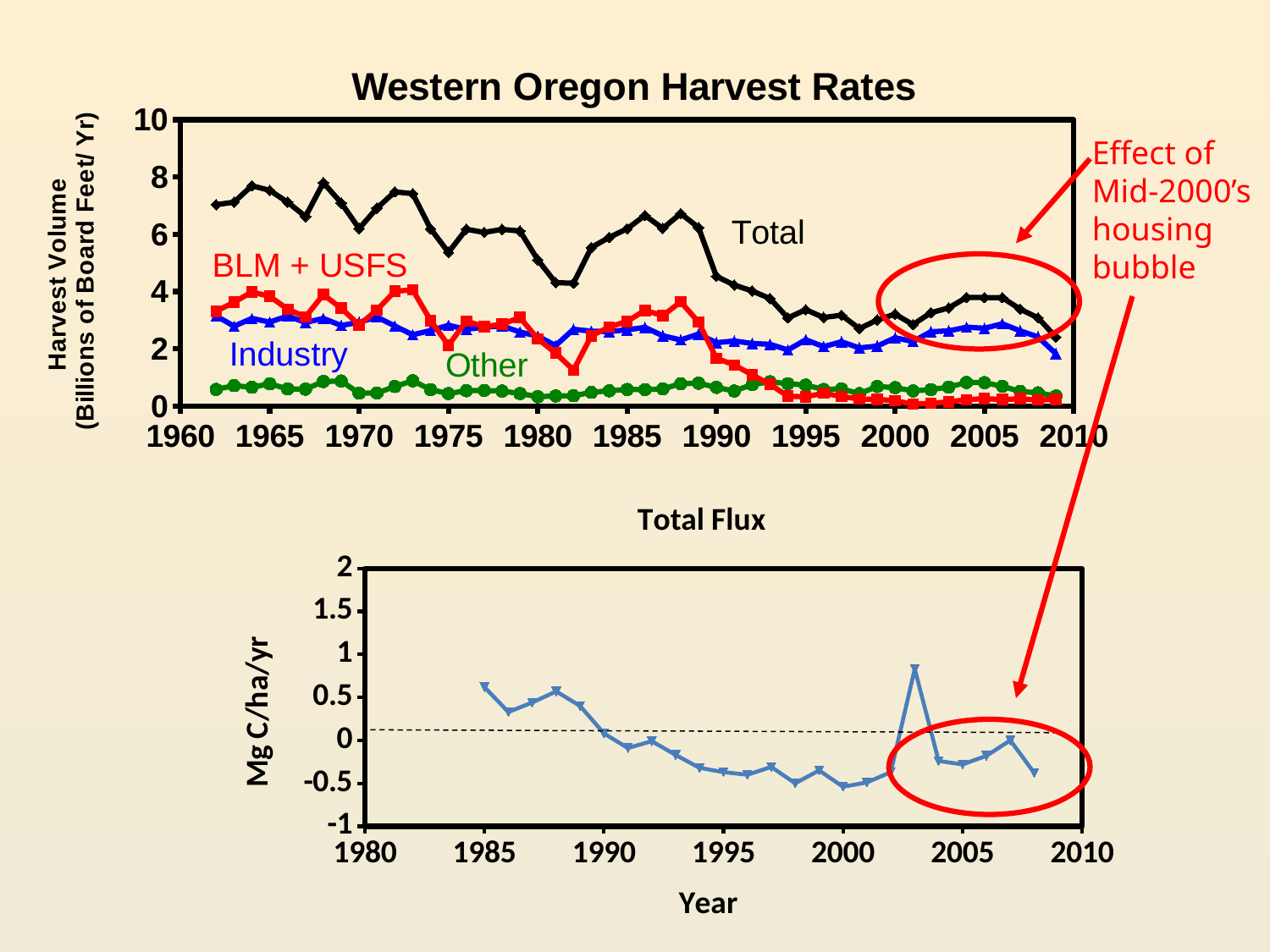
On the Total Flux chart, in which year is the value highest? 2003 What kind of chart is the Total Flux chart? line chart What is the y-axis label of the Total Flux chart? Mg C/ha/yr What kind of chart is the Western Oregon Harvest Rates chart? line chart On the Western Oregon Harvest Rates chart, is the Other value for 1970 greater or less than 2? less How many series are plotted on the Western Oregon Harvest Rates chart? 4 On the Western Oregon Harvest Rates chart, which series has the lowest value in 1975? Other On the Western Oregon Harvest Rates chart, is the BLM + USFS value for 2005 greater or less than 1? less On the Western Oregon Harvest Rates chart, is the Total value for 1962 greater or less than 6? greater On the Western Oregon Harvest Rates chart, which series is larger in 1965, Total or Other? Total On the Western Oregon Harvest Rates chart, does the BLM + USFS series rise or fall between 1988 and 1995? fall